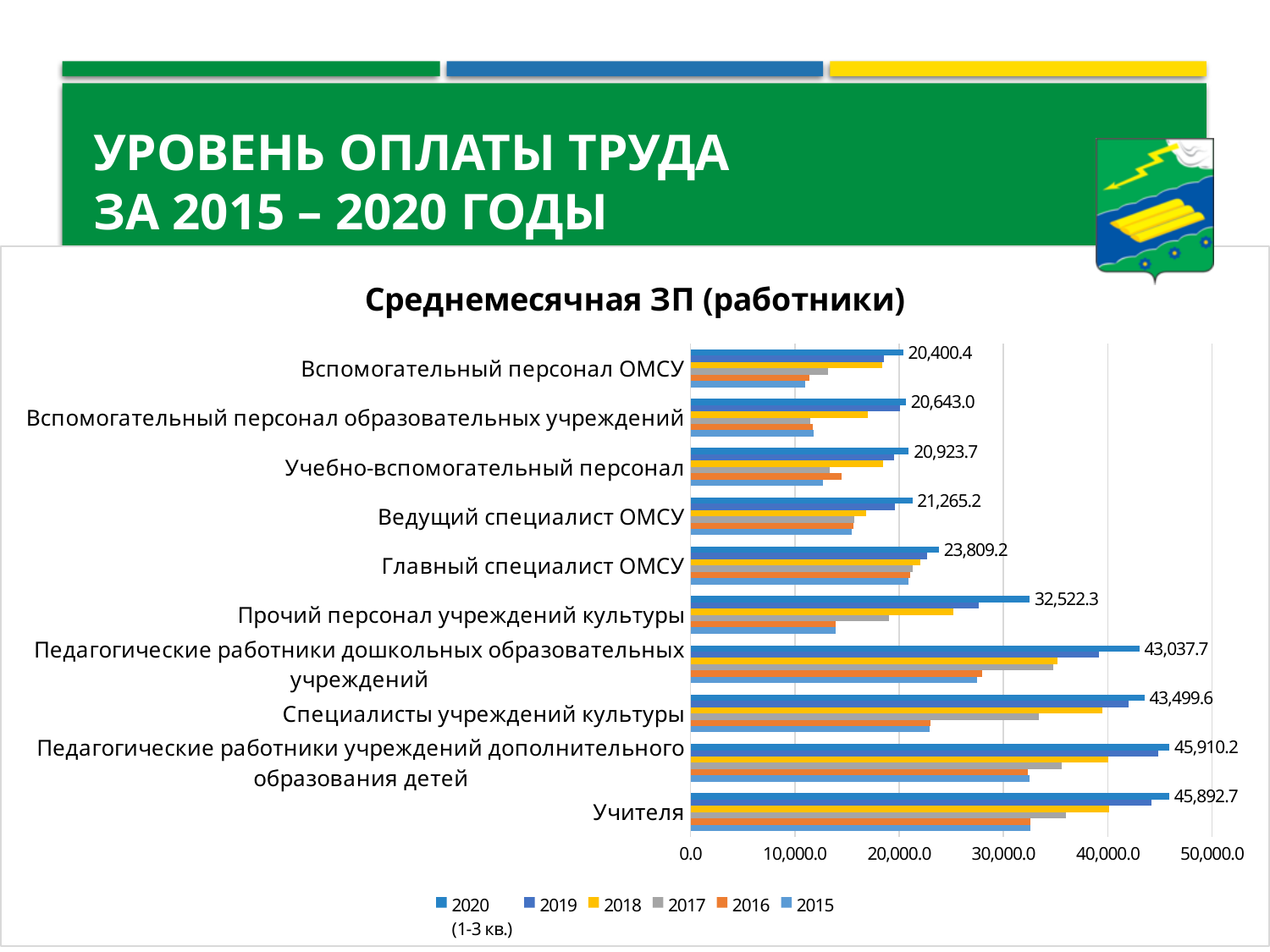
Which has a larger 2020 (1-3 кв.) value: Ведущий специалист ОМСУ or Главный специалист ОМСУ? Главный специалист ОМСУ What is the title of the chart? Среднемесячная ЗП (работники) Is the 2016 value for Специалисты учреждений культуры greater or less than 20,000.0? greater What is the difference between the 2020 (1-3 кв.) values for Специалисты учреждений культуры and Педагогические работники дошкольных образовательных учреждений? 461.9 What is the 2020 (1-3 кв.) value for Вспомогательный персонал образовательных учреждений? 20,643.0 How many series does the legend list? 6 What is the 2020 (1-3 кв.) value for Главный специалист ОМСУ? 23,809.2 What is the 2020 (1-3 кв.) value for Учителя? 45,892.7 How many categories are shown on the chart? 10 What is the 2020 (1-3 кв.) value for Прочий персонал учреждений культуры? 32,522.3 Is the 2015 value for Учителя greater or less than 30,000.0? greater What type of chart is shown on the slide? bar chart